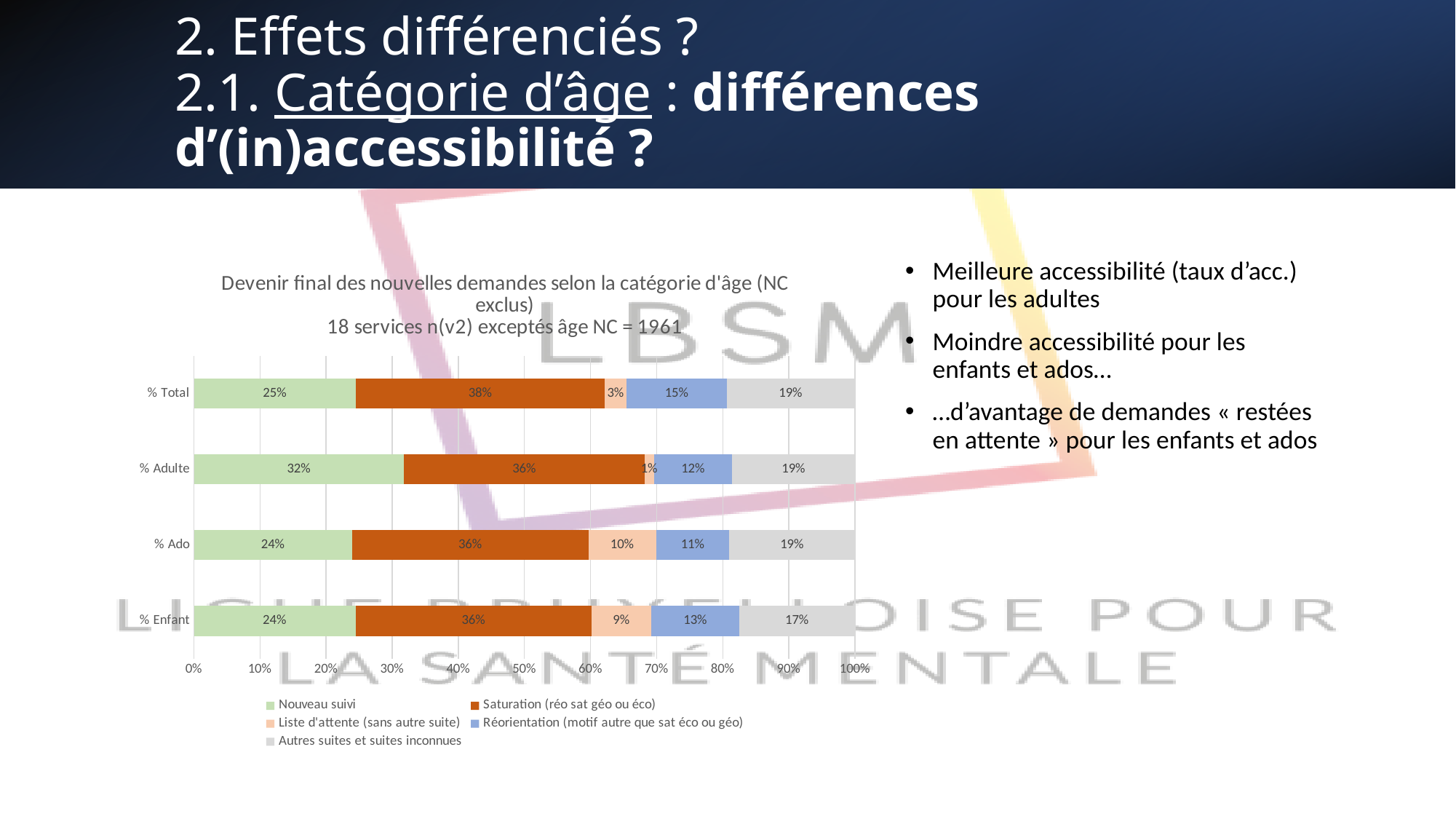
How many series does the chart legend list? 5 Which age category has the highest 'Nouveau suivi' value? % Adulte What is the difference between the 'Nouveau suivi' values for % Adulte and % Enfant? 8 percentage points How many age categories are plotted on the chart? 4 What is the 'Liste d'attente (sans autre suite)' value for % Ado? 10% Which category has the lowest 'Liste d'attente (sans autre suite)' value? % Adulte What is the title of the chart? Devenir final des nouvelles demandes selon la catégorie d'âge (NC exclus) 18 services n(v2) exceptés âge NC = 1961 What kind of chart is shown on the slide? Stacked bar chart What is the 'Autres suites et suites inconnues' value for % Enfant? 17% What is the 'Nouveau suivi' value for % Adulte? 32% Is the 'Liste d'attente (sans autre suite)' value larger for % Ado or for % Adulte? % Ado What is the 'Réorientation (motif autre que sat éco ou géo)' value for % Total? 15%